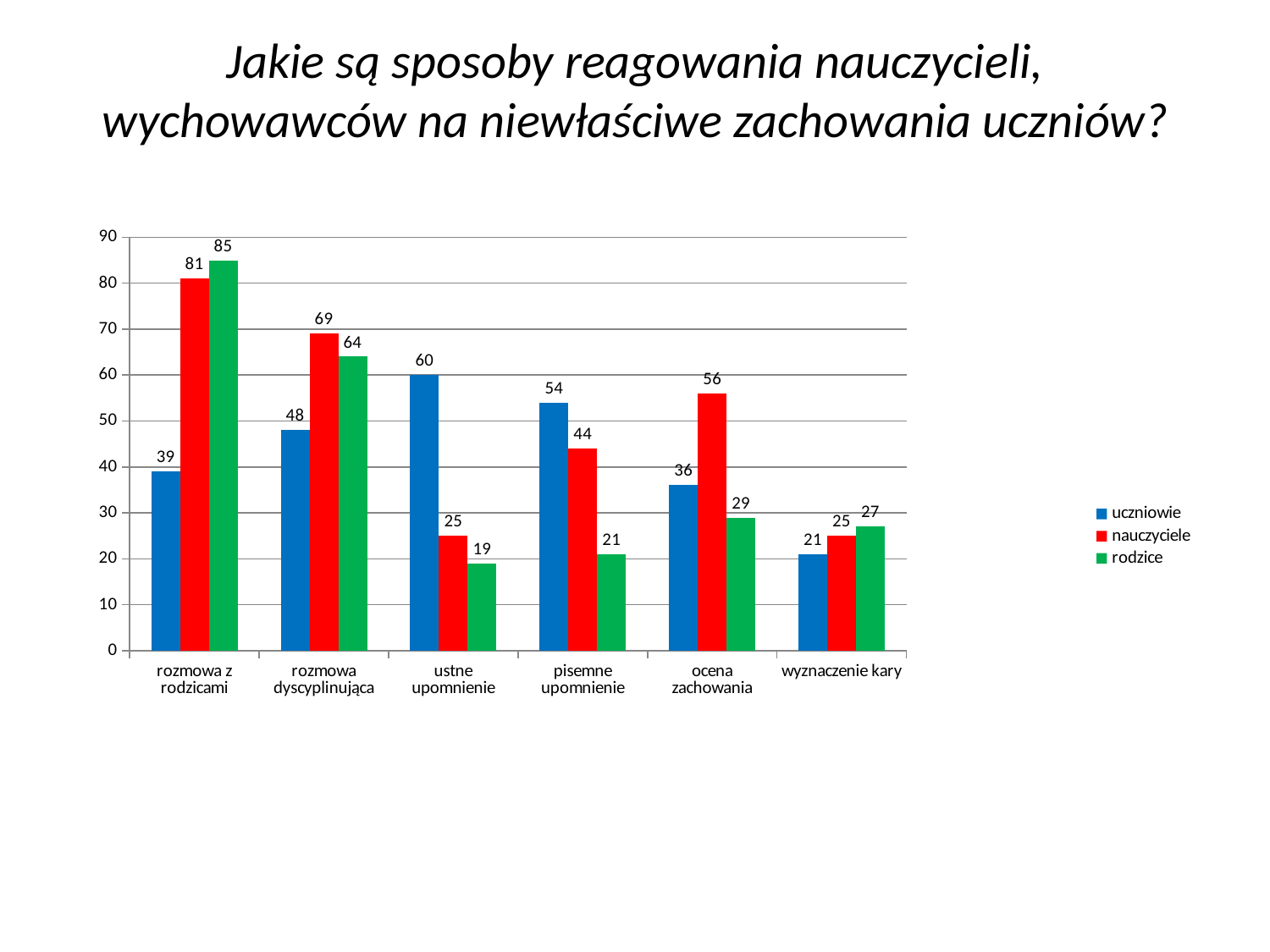
Which series is shown in green in the legend? rodzice What is the difference between the rodzice and uczniowie values in the 'wyznaczenie kary' category? 6 What is the value for uczniowie in the 'ustne upomnienie' category? 60 Which category has the highest value for the nauczyciele series? rozmowa z rodzicami How many categories are shown on the x axis? 6 How many series does the legend list? 3 What is the difference between the nauczyciele and uczniowie values in the 'rozmowa z rodzicami' category? 42 Which is larger in the 'pisemne upomnienie' category: uczniowie or nauczyciele? uczniowie What is the value for rodzice in the 'rozmowa z rodzicami' category? 85 What is the value for nauczyciele in the 'ocena zachowania' category? 56 What kind of chart is shown on the slide? bar chart Which category has the lowest value for the rodzice series? ustne upomnienie